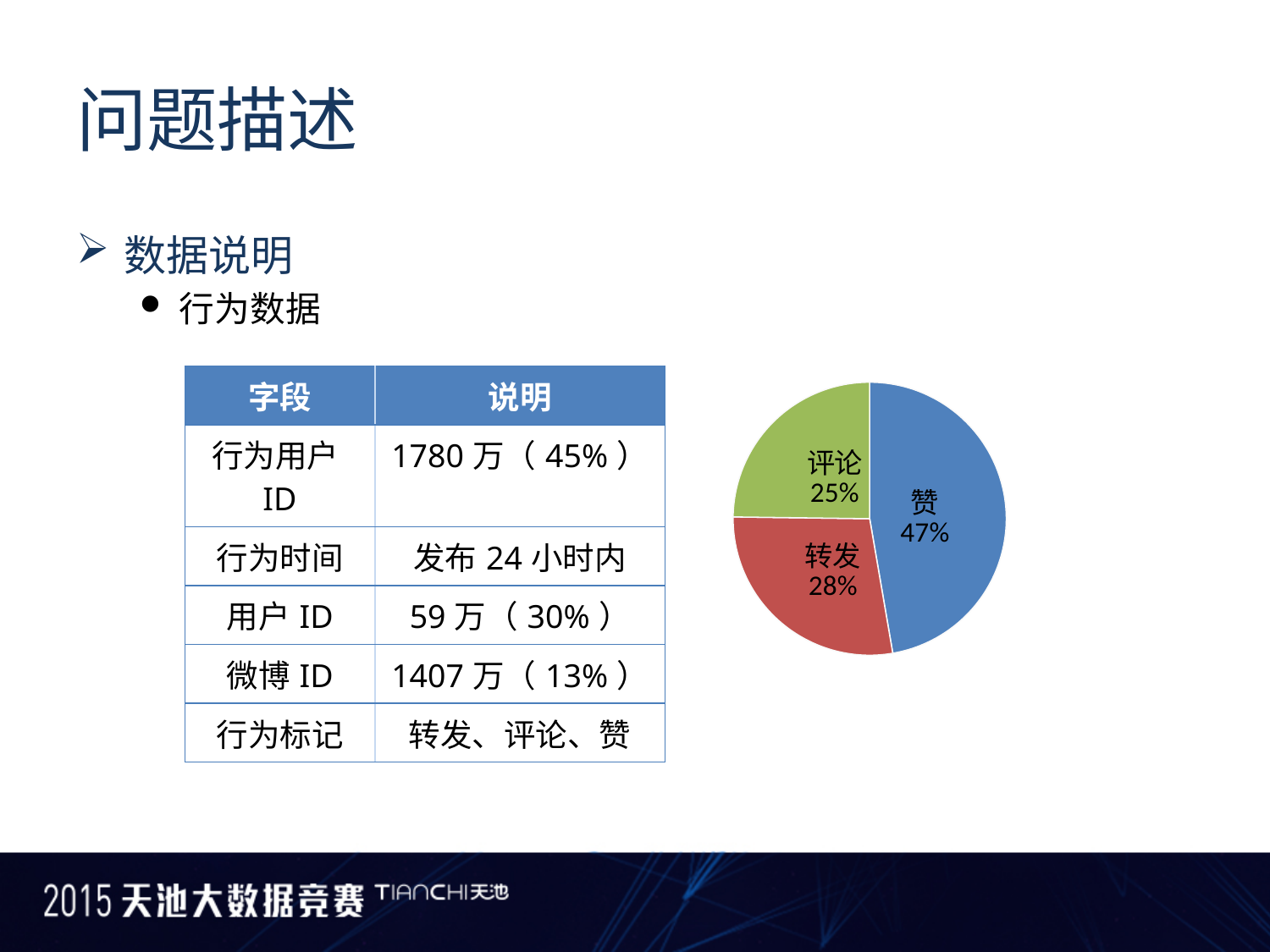
What colour is the 评论 slice in the pie chart? green What colour is the 赞 slice in the pie chart? blue How many slices does the pie chart have? 3 What share of the pie chart does 转发 represent? 28% Which slice of the pie chart is the smallest? 评论 Which slice of the pie chart is the largest? 赞 What kind of chart is shown on the slide? pie chart What share of the pie chart does 赞 represent? 47% What is the difference in percentage points between the 转发 slice and the 评论 slice? 3% What share of the pie chart does 评论 represent? 25% Which is larger in the pie chart, 转发 or 评论? 转发 What is the difference in percentage points between the 赞 slice and the 转发 slice? 19%